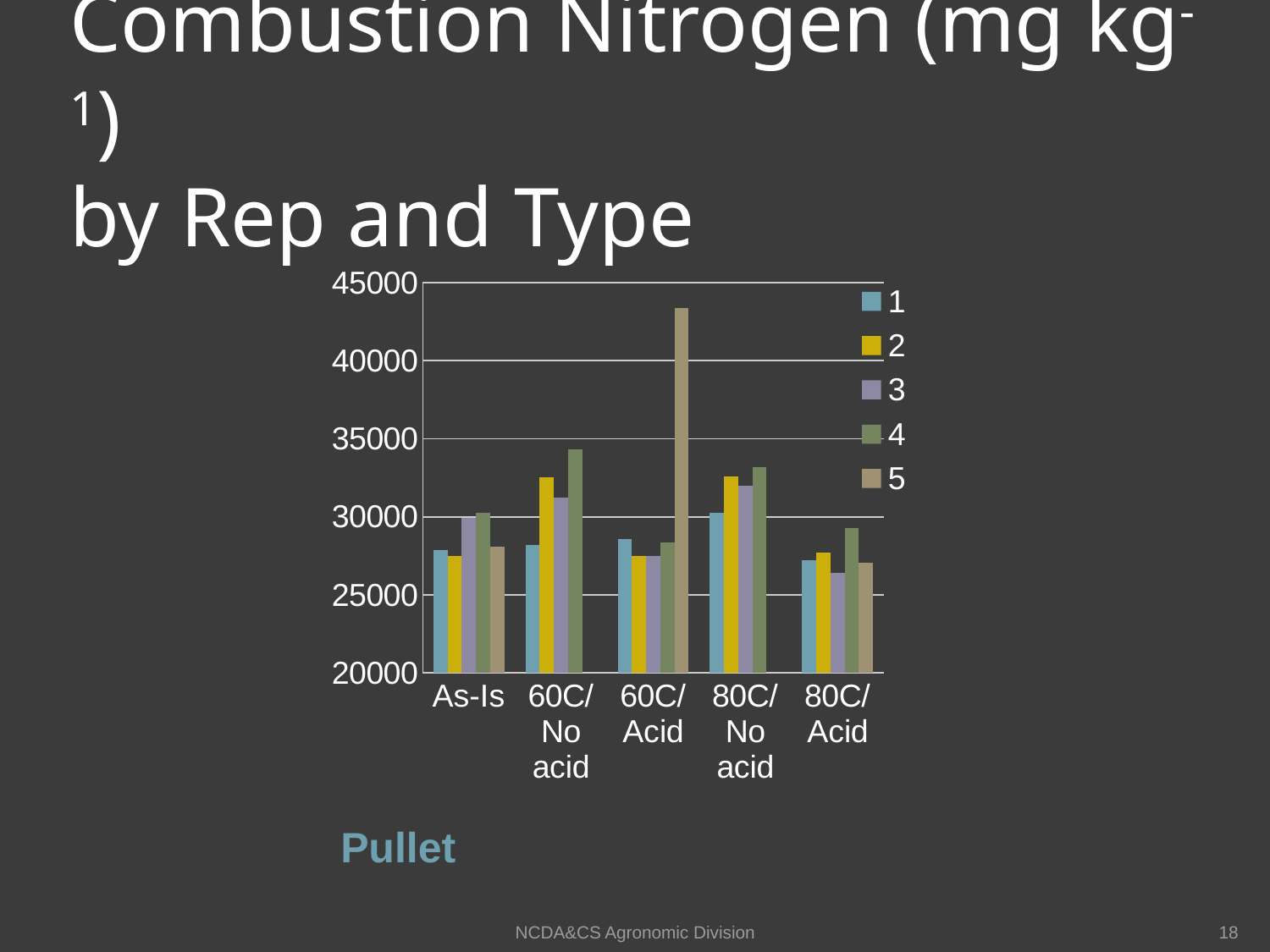
Which series has the tallest bar in the 60C/Acid category? 5 Is the value for series 1 in the As-Is category greater or less than 30000? less What kind of chart is shown on the slide? bar chart Which series has the lowest bar in the 60C/No acid category? 1 Is the value for series 5 in the 60C/Acid category greater or less than 40000? greater How many series does the legend list? 5 Is the value for series 4 in the 80C/No acid category greater or less than 30000? greater How many categories are shown on the x axis? 5 In the 80C/No acid category, which is larger: series 1 or series 2? series 2 What label appears below the chart? Pullet Which category contains the tallest bar in the chart? 60C/Acid